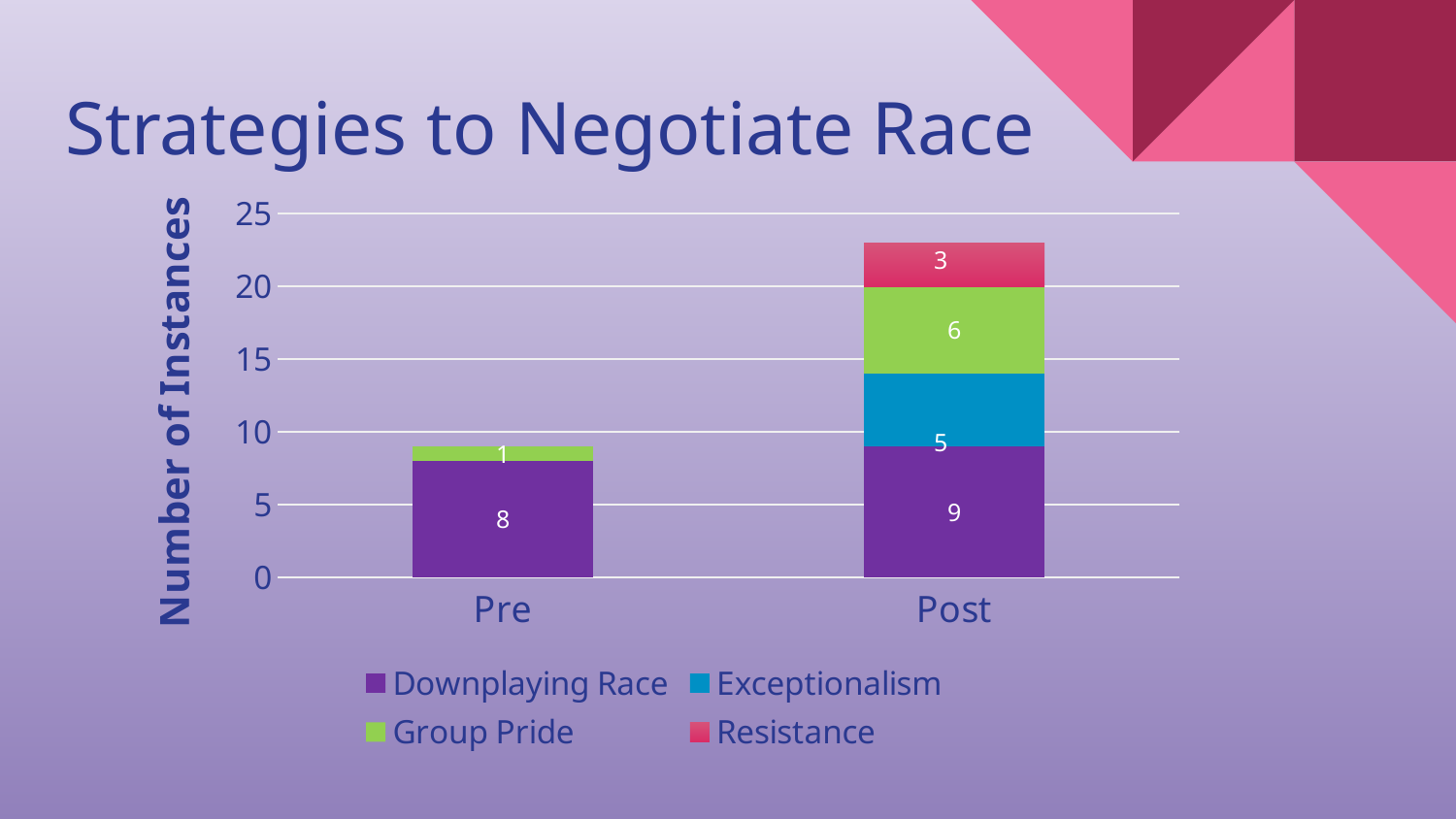
How many categories are shown on the x axis? 2 What kind of chart is shown on the slide? Stacked bar chart What is the total of the Post stacked bar? 23 What is the total of the Pre stacked bar? 9 What is the value for Downplaying Race in the Pre bar? 8 What is the value for Resistance in the Post bar? 3 What is the value for Exceptionalism in the Post bar? 5 Which category has the larger Downplaying Race value, Pre or Post? Post What is the label of the y axis? Number of Instances What is the value for Group Pride in the Post bar? 6 How many series does the legend list? 4 What is the difference between the Group Pride values for Post and Pre? 5